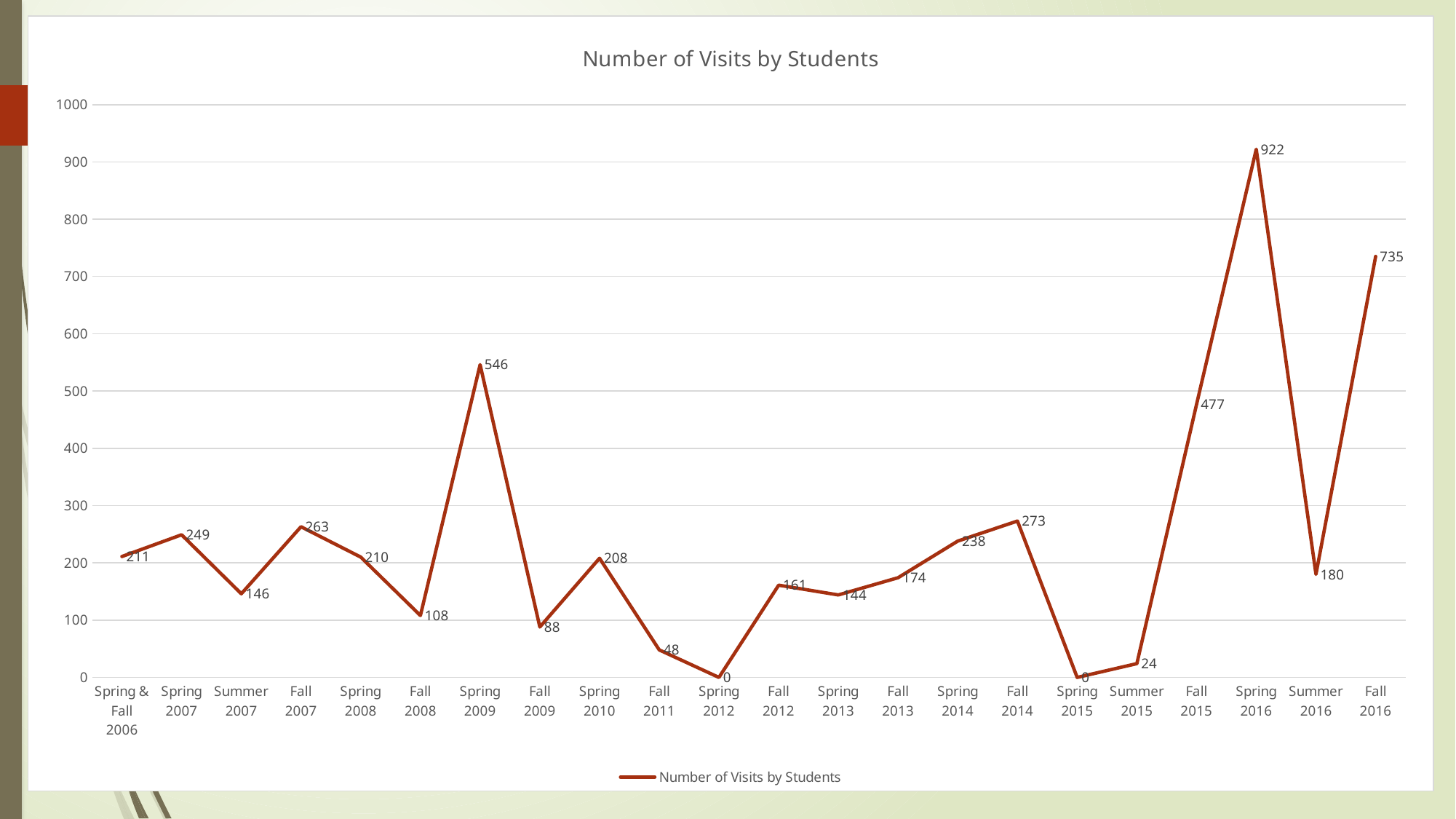
Is the value for Fall 2015 greater or less than 400? greater What is the number of visits by students in Summer 2015? 24 What is the difference in visits between Spring 2016 and Fall 2016? 187 What is the number of visits by students in Fall 2008? 108 What is the number of visits by students in Spring 2016? 922 Do the values rise or fall from Spring 2015 to Spring 2016? rise What is the difference in visits between Spring 2009 and Fall 2009? 458 What kind of chart is shown on the slide? line chart What is the lowest number of visits shown on the chart? 0 How many periods are plotted on the x axis? 22 Which period has the highest number of visits by students? Spring 2016 Which has more visits, Spring 2009 or Fall 2015? Spring 2009